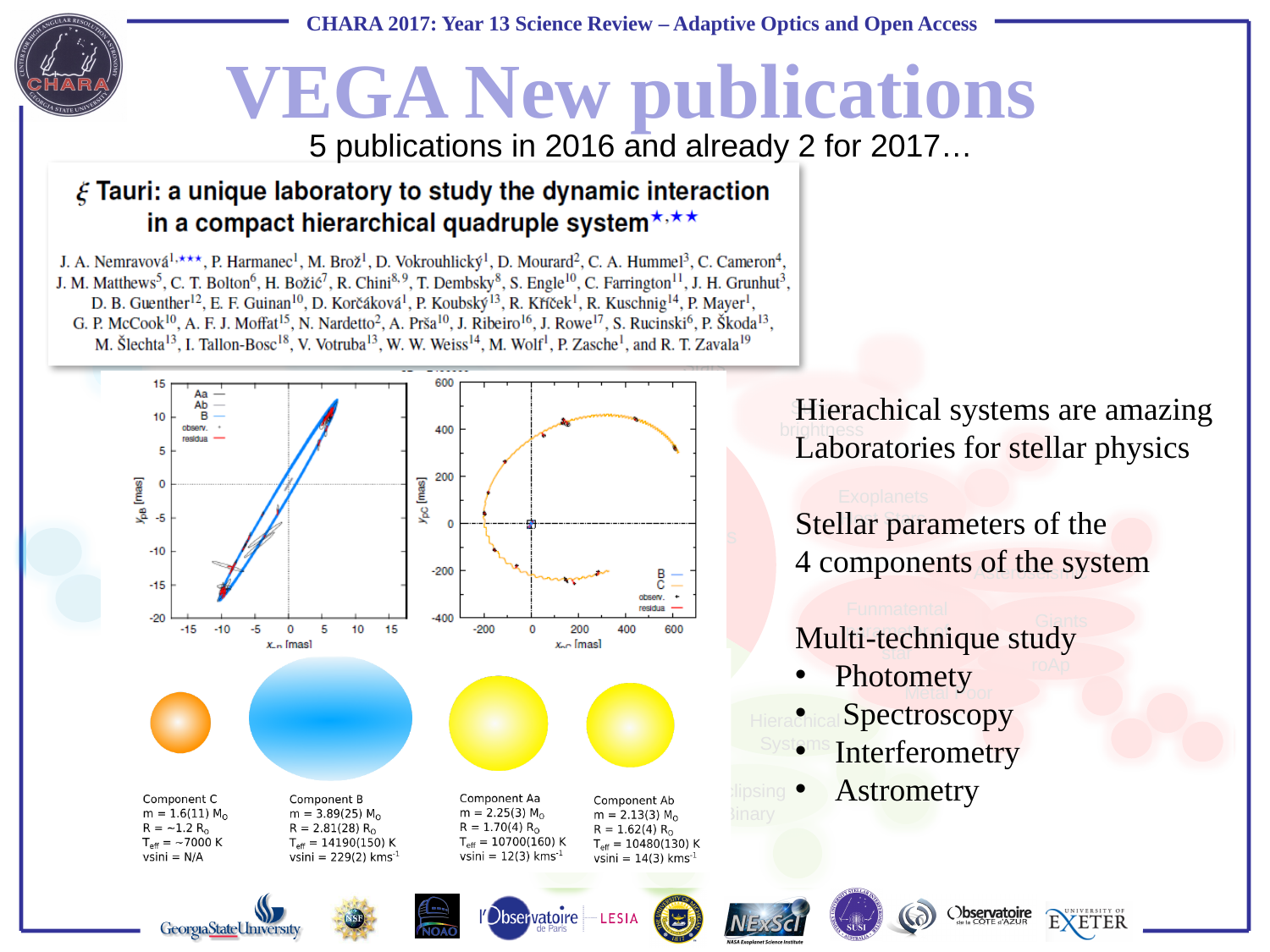
How many entries does the legend of the left chart list? 5 What is the label of the x axis of the right chart? x_pC [mas] What is the highest tick value shown on the y axis of the right chart? 600 What is the lowest tick value shown on the x axis of the right chart? -200 How many entries does the legend of the right chart list? 4 How many charts (plots) are shown on the slide? 2 In the component diagram below the charts, what is the mass given for Component B? 3.89(25) M☉ In the component diagram below the charts, which component has the highest effective temperature (Teff)? Component B What is the lowest tick value shown on the y axis of the left chart? -20 What unit is used on both axes of the left chart? mas In the component diagram below the charts, what is the vsini value given for Component Aa? 12(3) km s⁻¹ Which chart covers a larger range of values on its axes, the left chart or the right chart? the right chart